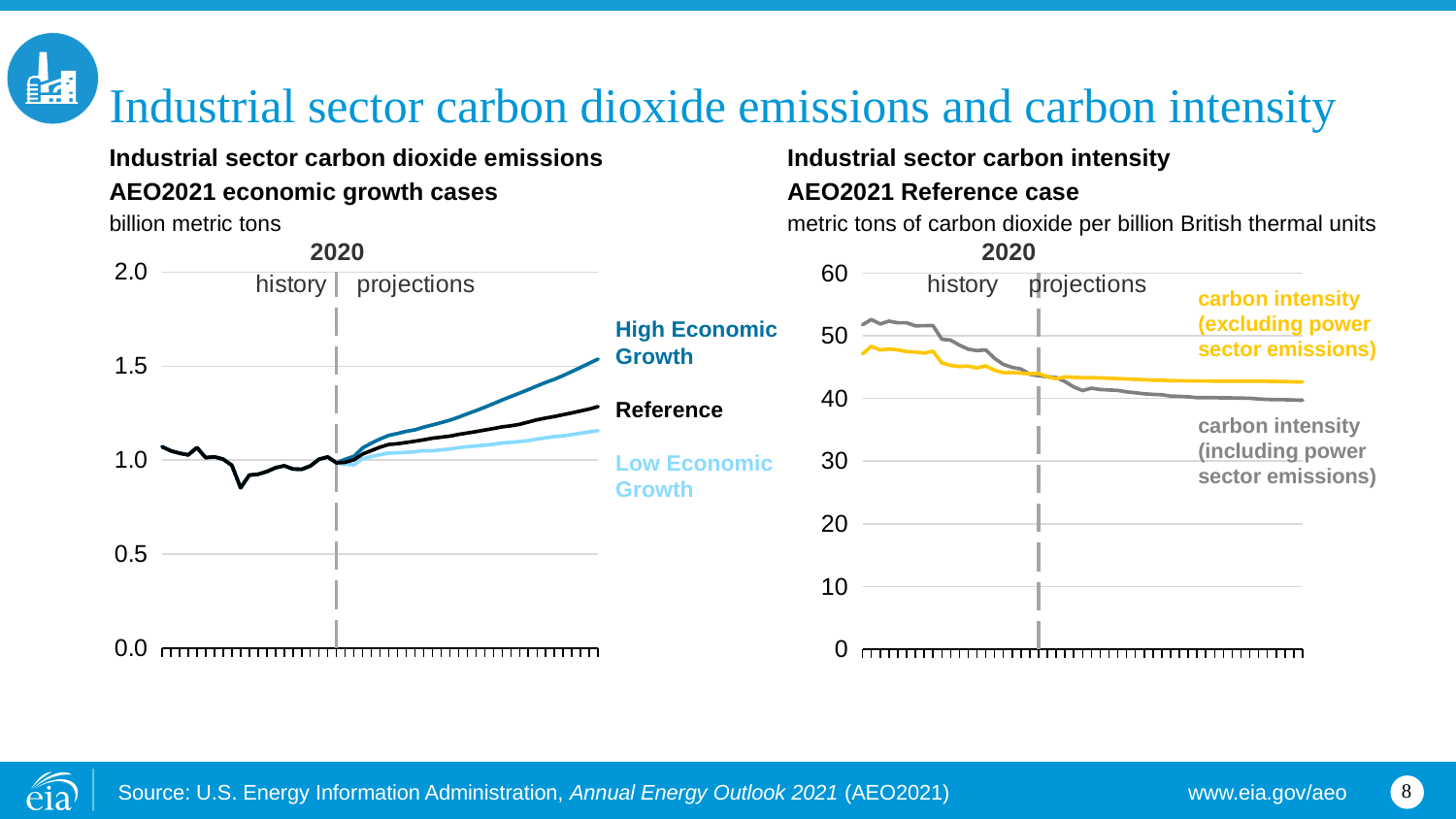
On the left chart, do the projected emissions rise or fall after 2020 in the High Economic Growth case? rise What kind of chart is the 'Industrial sector carbon dioxide emissions' chart on the left? line chart On the left chart, is the Low Economic Growth value at the end of the projection period greater or less than 1.0? greater On the right chart, at the end of the projection period, which series is higher: carbon intensity excluding power sector emissions or including power sector emissions? carbon intensity (excluding power sector emissions) What unit is used on the y axis of the 'Industrial sector carbon intensity' chart on the right? metric tons of carbon dioxide per billion British thermal units How many series are shown on the 'Industrial sector carbon intensity' chart on the right? 2 On the right chart, is the carbon intensity (excluding power sector emissions) at the end of the projection period greater or less than 40? greater On the right chart, does carbon intensity (including power sector emissions) rise or fall over the period shown? fall On the right chart, is the carbon intensity (including power sector emissions) at the start of the history period greater or less than 50? greater How many series are shown on the 'Industrial sector carbon dioxide emissions' chart on the left? 3 On the left chart, at the end of the projection period, which series is higher: High Economic Growth or Low Economic Growth? High Economic Growth